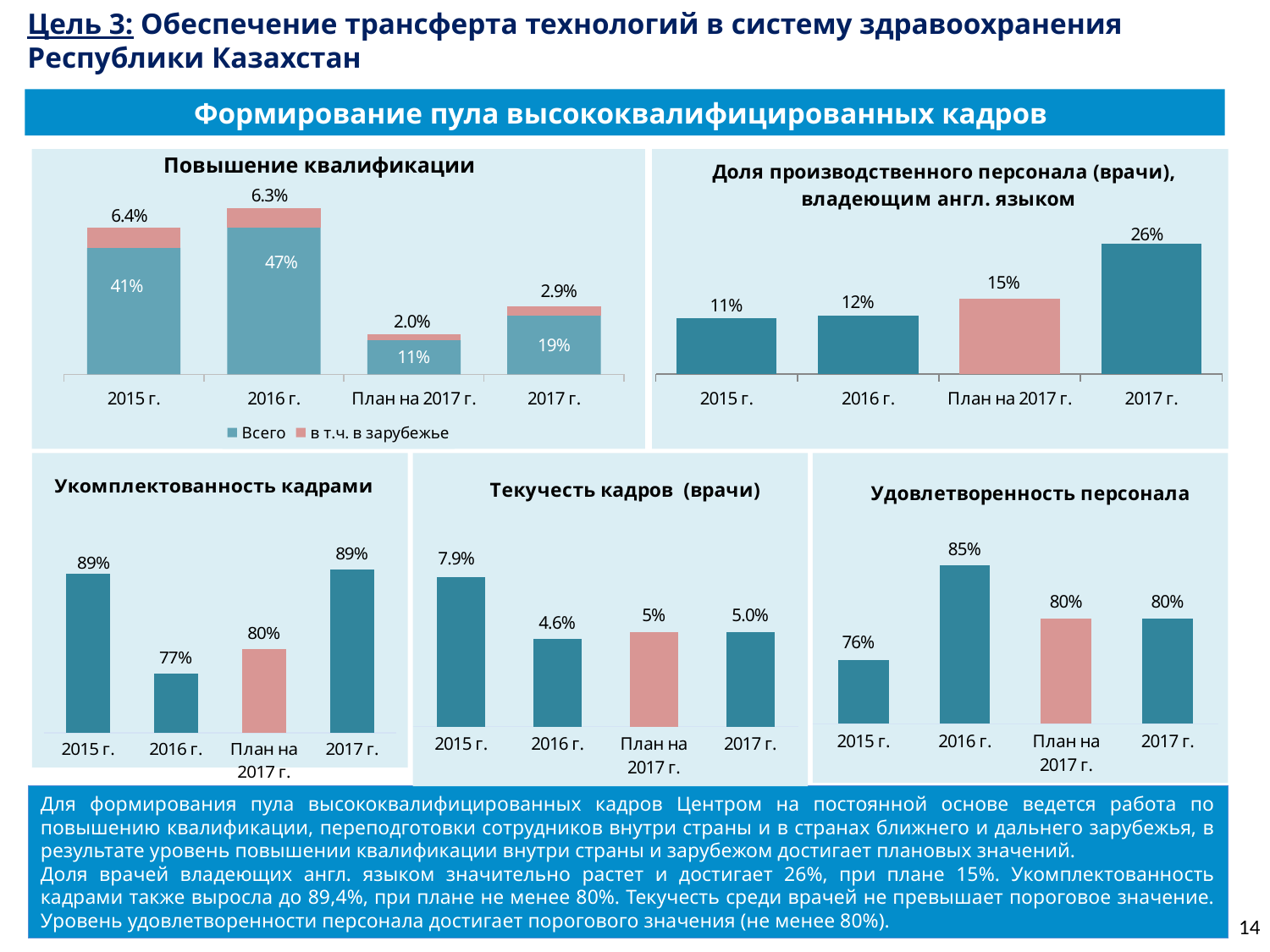
What kind of chart is 'Доля производственного персонала (врачи), владеющим англ. языком'? Bar chart In the chart 'Укомплектованность кадрами', what is the difference between the values for 2017 г. and План на 2017 г.? 9% In the chart 'Удовлетворенность персонала', which is larger, the value for 2015 г. or the value for 2016 г.? 2016 г. In the chart 'Повышение квалификации', what is the value of the 'Всего' series for 2016 г.? 47% In the chart 'Доля производственного персонала (врачи), владеющим англ. языком', what is the value for 2017 г.? 26% How many series does the legend of the chart 'Повышение квалификации' list? 2 In the chart 'Текучесть кадров (врачи)', which category has the highest value? 2015 г. In the chart 'Повышение квалификации', what is the value of the 'в т.ч. в зарубежье' series for План на 2017 г.? 2.0% In the chart 'Текучесть кадров (врачи)', what is the value for 2016 г.? 4.6% How many categories are shown on the x axis of the chart 'Удовлетворенность персонала'? 4 In the chart 'Доля производственного персонала (врачи), владеющим англ. языком', which category has the lowest value? 2015 г. In the chart 'Укомплектованность кадрами', what is the value for 2016 г.? 77%